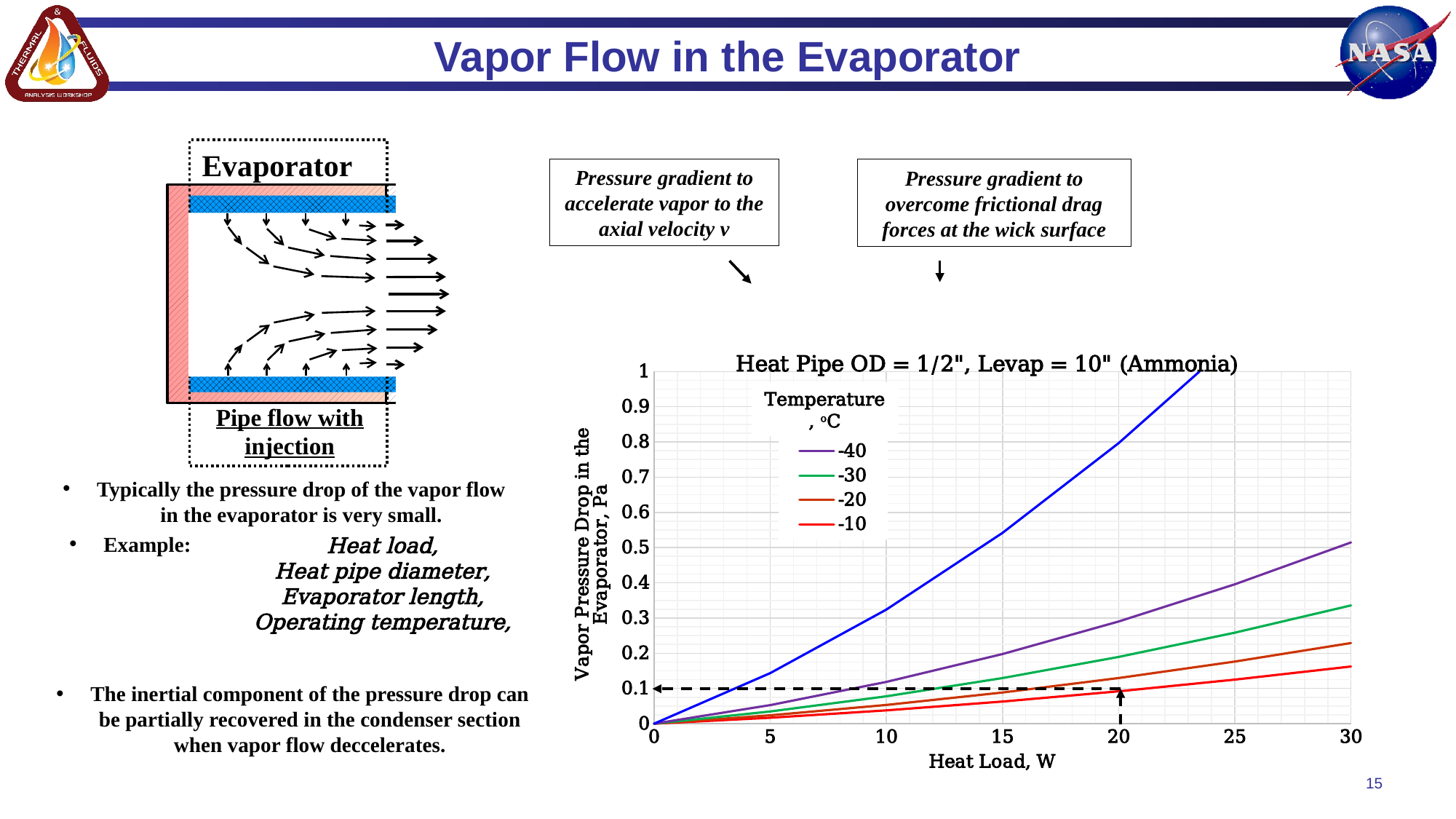
What kind of chart is shown on the slide? line chart Do the vapor pressure drop curves rise or fall as heat load increases? rise Is the vapor pressure drop for the -40 °C curve at 20 W greater or less than 0.2 Pa? greater Among the temperatures listed in the legend, which has the lowest vapor pressure drop at a heat load of 30 W? -10 At a heat load of 30 W, which has the larger vapor pressure drop: the -30 °C curve or the -20 °C curve? -30 Is the vapor pressure drop for the -10 °C curve at 30 W greater or less than 0.2 Pa? less What is the title of the chart? Heat Pipe OD = 1/2", Levap = 10" (Ammonia) Is the vapor pressure drop for the -20 °C curve at 30 W greater or less than 0.3 Pa? less How many temperature series does the chart legend list? 4 Among the temperatures listed in the legend, which has the highest vapor pressure drop at a heat load of 30 W? -40 What is the label of the chart's x axis? Heat Load, W